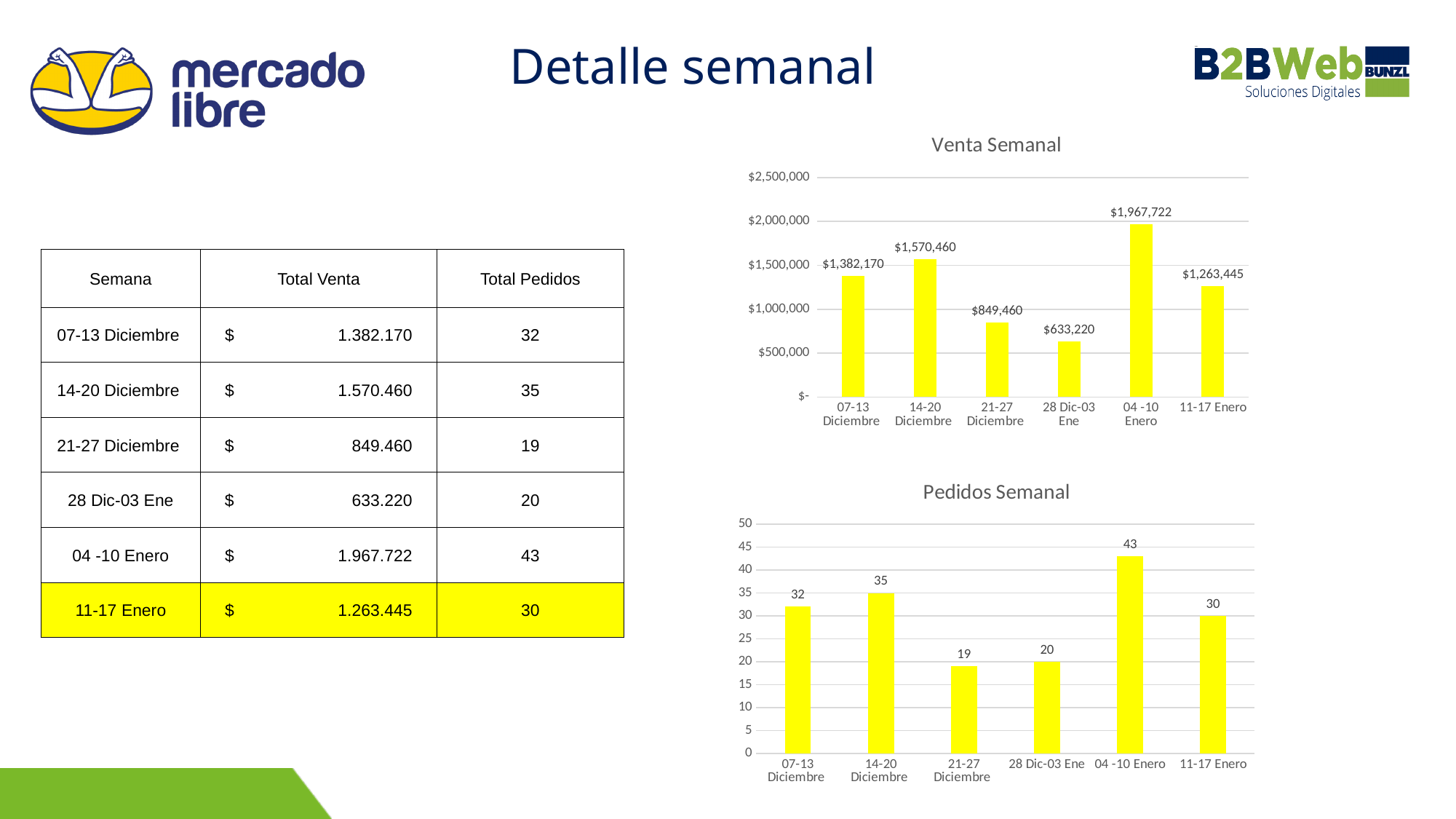
In the 'Pedidos Semanal' chart, what is the difference between 04 -10 Enero and 28 Dic-03 Ene? 23 In the 'Venta Semanal' chart, what is the value for 28 Dic-03 Ene? $633,220 In the 'Venta Semanal' chart, is the value for 21-27 Diciembre greater or less than $1,000,000? less In the 'Pedidos Semanal' chart, what is the value for 11-17 Enero? 30 What kind of chart is the 'Pedidos Semanal' chart? bar chart In the 'Venta Semanal' chart, what is the value for 04 -10 Enero? $1,967,722 In the 'Pedidos Semanal' chart, which is larger: 07-13 Diciembre or 14-20 Diciembre? 14-20 Diciembre In the 'Venta Semanal' chart, which week has the lowest value? 28 Dic-03 Ene In the 'Pedidos Semanal' chart, which week has the lowest value? 21-27 Diciembre In the 'Venta Semanal' chart, how many weeks are plotted? 6 In the 'Pedidos Semanal' chart, which week has the highest value? 04 -10 Enero In the 'Venta Semanal' chart, what is the difference between 14-20 Diciembre and 07-13 Diciembre? $188,290